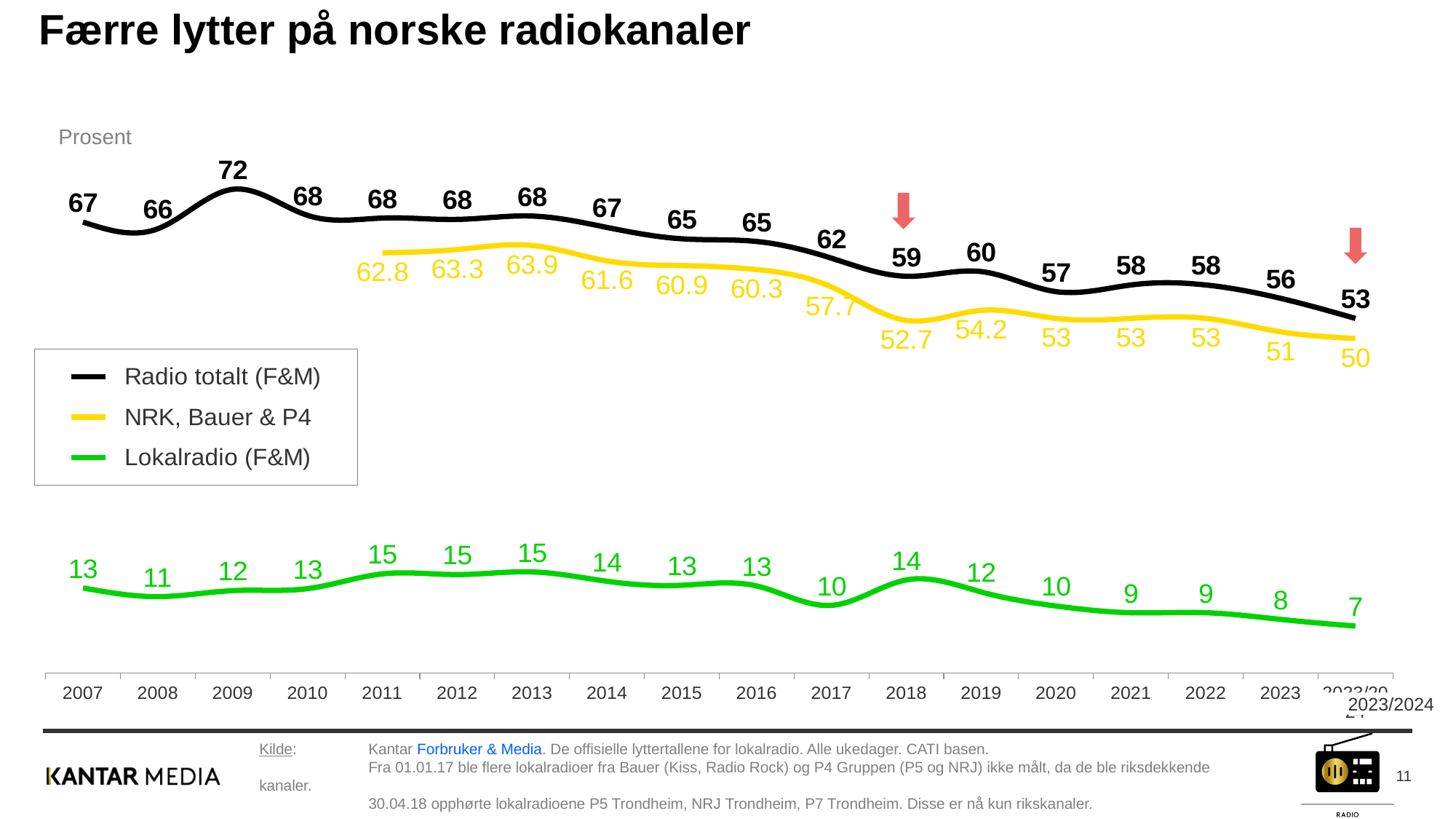
What was the value for Lokalradio (F&M) in 2023/2024? 7 What kind of chart is shown on the slide? Line chart In which year did Radio totalt (F&M) reach its highest value? 2009 Which year had the higher value for Lokalradio (F&M), 2017 or 2018? 2018 How many series does the legend list? 3 In which year was Lokalradio (F&M) at its lowest value? 2023/2024 How many time points are shown on the x axis? 18 What was the value for NRK, Bauer & P4 in 2013? 63.9 What was the value for Radio totalt (F&M) in 2009? 72 By how many percentage points did Radio totalt (F&M) fall from 2007 to 2023/2024? 14 Does the Radio totalt (F&M) series generally rise or fall from 2007 to 2023/2024? Fall What is the difference between the NRK, Bauer & P4 values for 2017 and 2018? 5.0